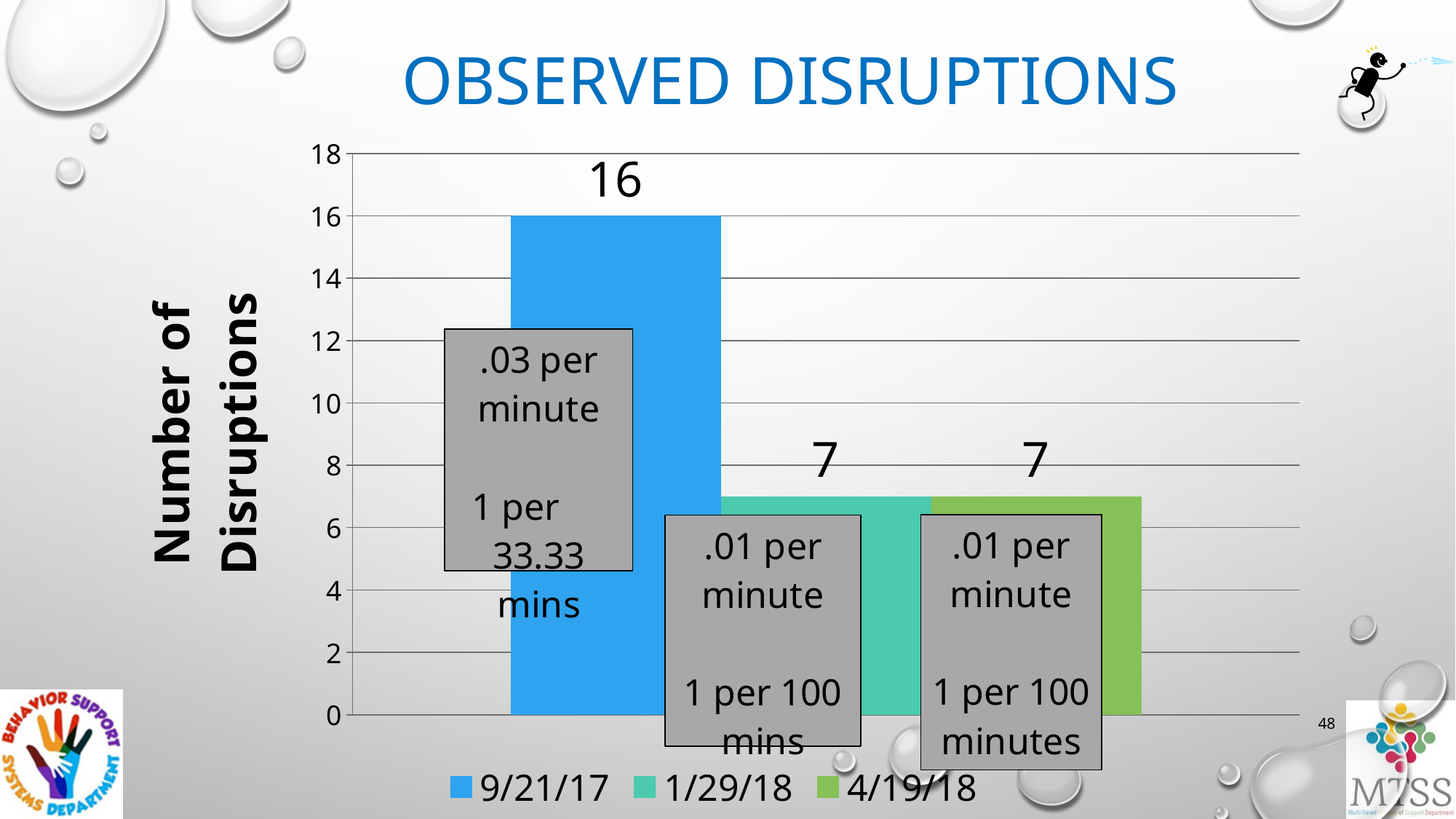
What is the number of disruptions observed on 4/19/18? 7 Which has more observed disruptions, 9/21/17 or 4/19/18? 9/21/17 Is the value for 9/21/17 greater or less than 14? greater What is the title of the chart? Observed Disruptions Do the observed disruptions rise or fall from 9/21/17 to 4/19/18? fall What is the number of disruptions observed on 9/21/17? 16 What kind of chart is shown on the slide? bar chart What is the difference in disruptions between 9/21/17 and 1/29/18? 9 How many series does the legend list? 3 Which date has the highest number of observed disruptions? 9/21/17 What is the number of disruptions observed on 1/29/18? 7 Is the value for 1/29/18 greater or less than 10? less